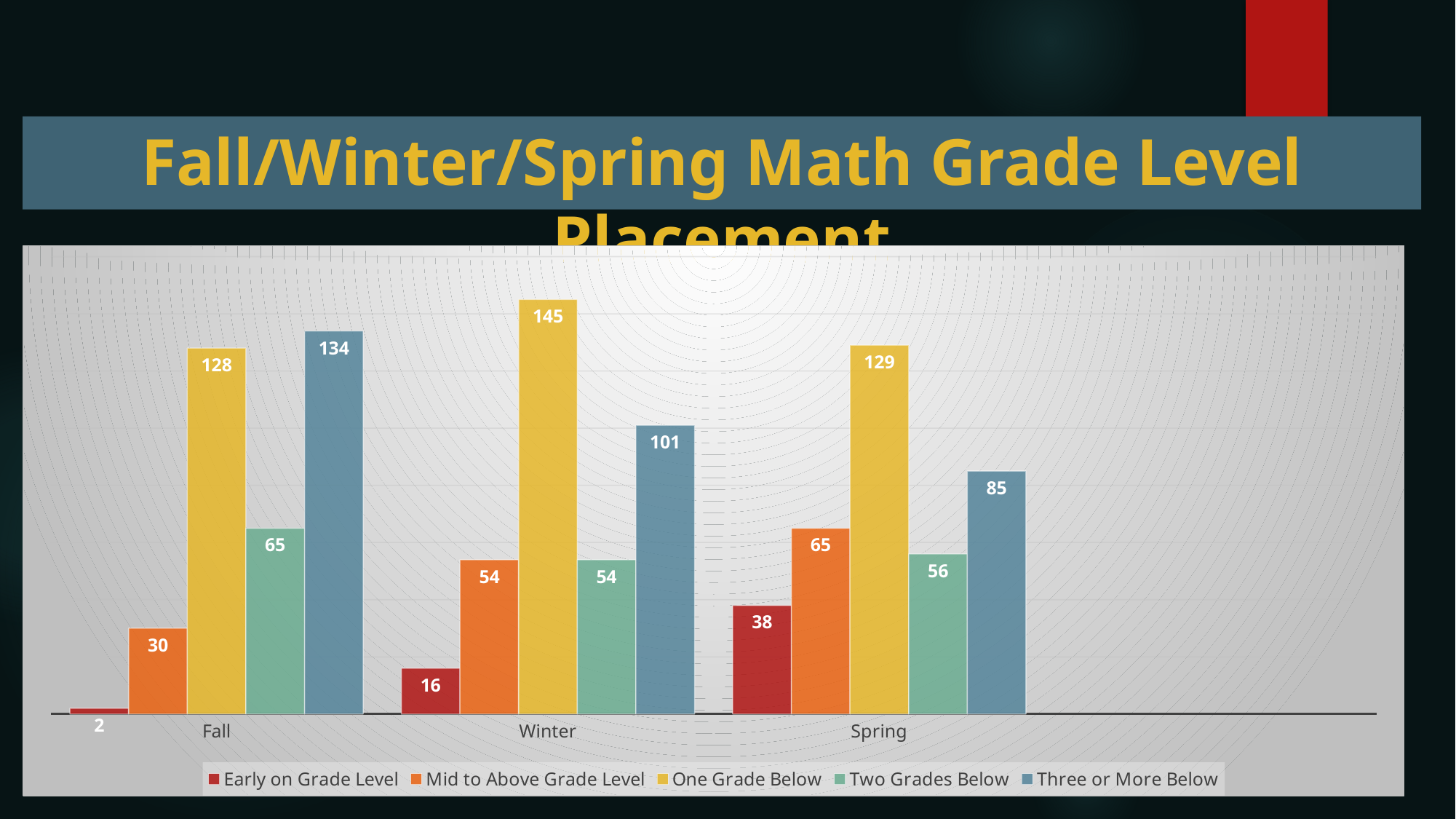
How many series does the legend list? 5 Which season has the lowest value for Early on Grade Level? Fall What is the value for Early on Grade Level in Spring? 38 What is the value for One Grade Below in Winter? 145 Which season has the highest value for One Grade Below? Winter What kind of chart is shown on the slide? Bar chart Do the values for Three or More Below rise or fall from Fall to Spring? Fall Which is larger: Two Grades Below in Fall or Two Grades Below in Spring? Two Grades Below in Fall What is the value for Three or More Below in Fall? 134 What is the difference between the Three or More Below values for Fall and Spring? 49 How many seasons are shown on the x axis? 3 What is the value for Mid to Above Grade Level in Winter? 54